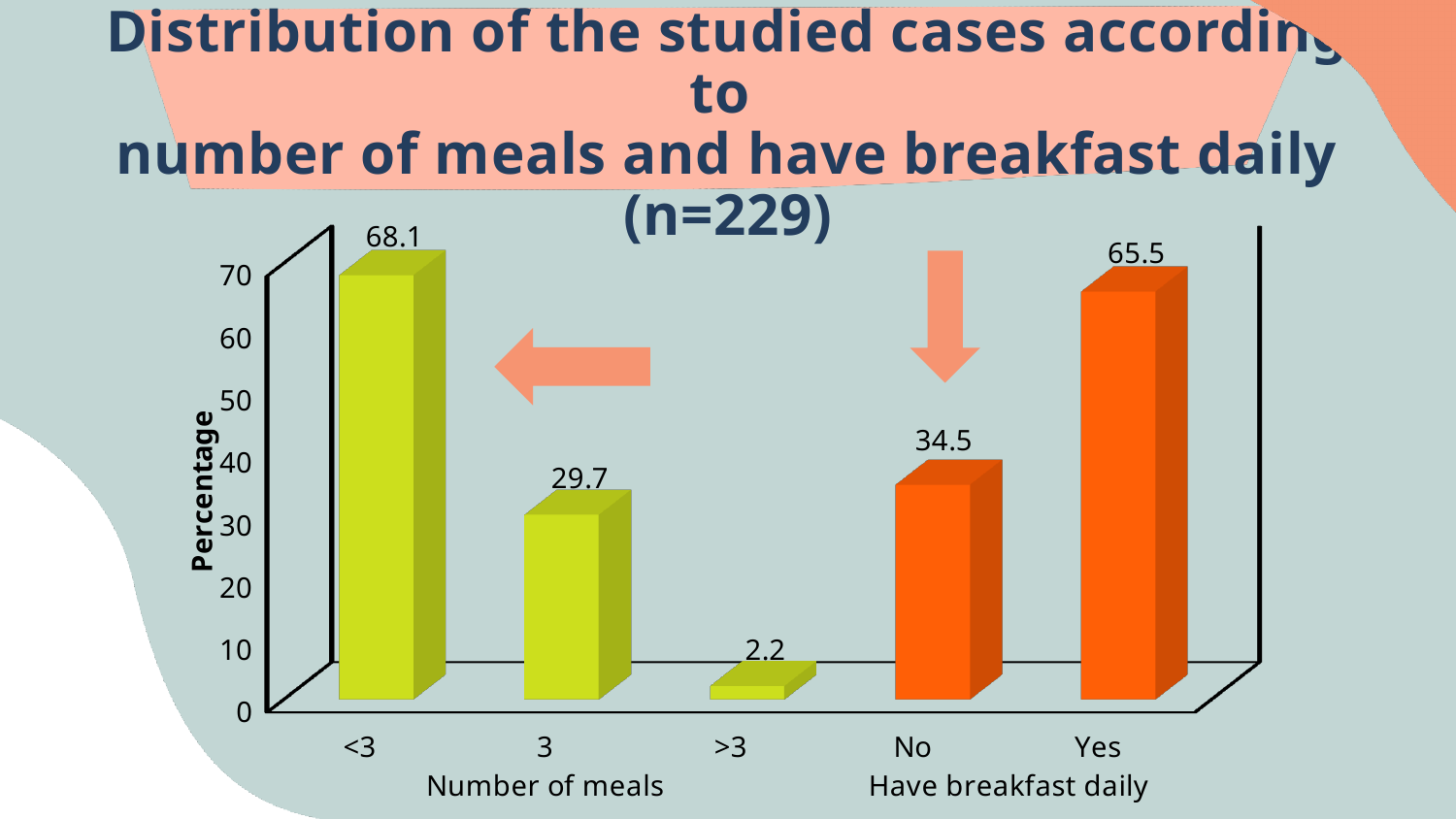
What percentage of studied cases have breakfast daily (Yes)? 65.5 Which number-of-meals category has the highest percentage? <3 What is the difference in percentage between cases having breakfast daily (Yes) and not having it (No)? 31 How many categories are plotted on the chart in total? 5 Which is larger: the percentage for <3 meals or the percentage for Yes (have breakfast daily)? <3 meals What percentage of studied cases do not have breakfast daily (No)? 34.5 What percentage of studied cases have 3 meals? 29.7 What percentage of studied cases have fewer than 3 meals (<3)? 68.1 What type of chart is shown on the slide? Bar chart What percentage of studied cases have more than 3 meals (>3)? 2.2 Which number-of-meals category has the lowest percentage? >3 What is the difference in percentage between the <3 meals and 3 meals categories? 38.4